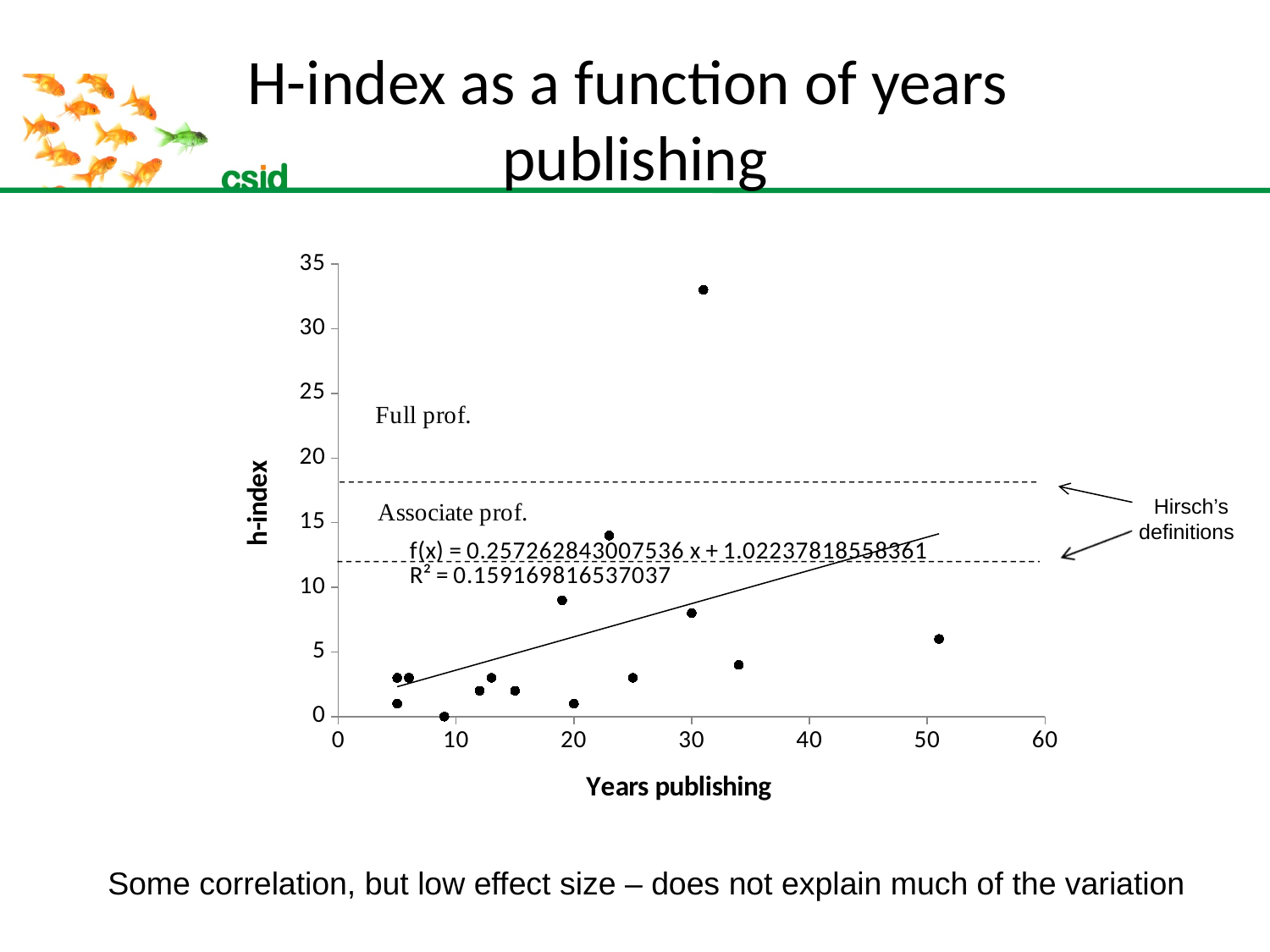
What is the title of the chart? H-index as a function of years publishing Is the h-index of the point with the most years publishing (around 50 years) greater or less than 10? less How many data points are plotted on the chart? 15 What kind of chart is shown on the slide? scatter plot Is the dashed line labelled 'Associate prof.' above or below an h-index of 15? below Is the highest h-index plotted greater or less than 30? greater What is the slope of the fitted line printed on the chart? 0.257262843007536 What is the label of the x axis? Years publishing What is the intercept of the fitted line printed on the chart? 1.02237818558361 What R² value is printed on the chart? R² = 0.159169816537037 Does the fitted trend line rise or fall as years publishing increases? rise